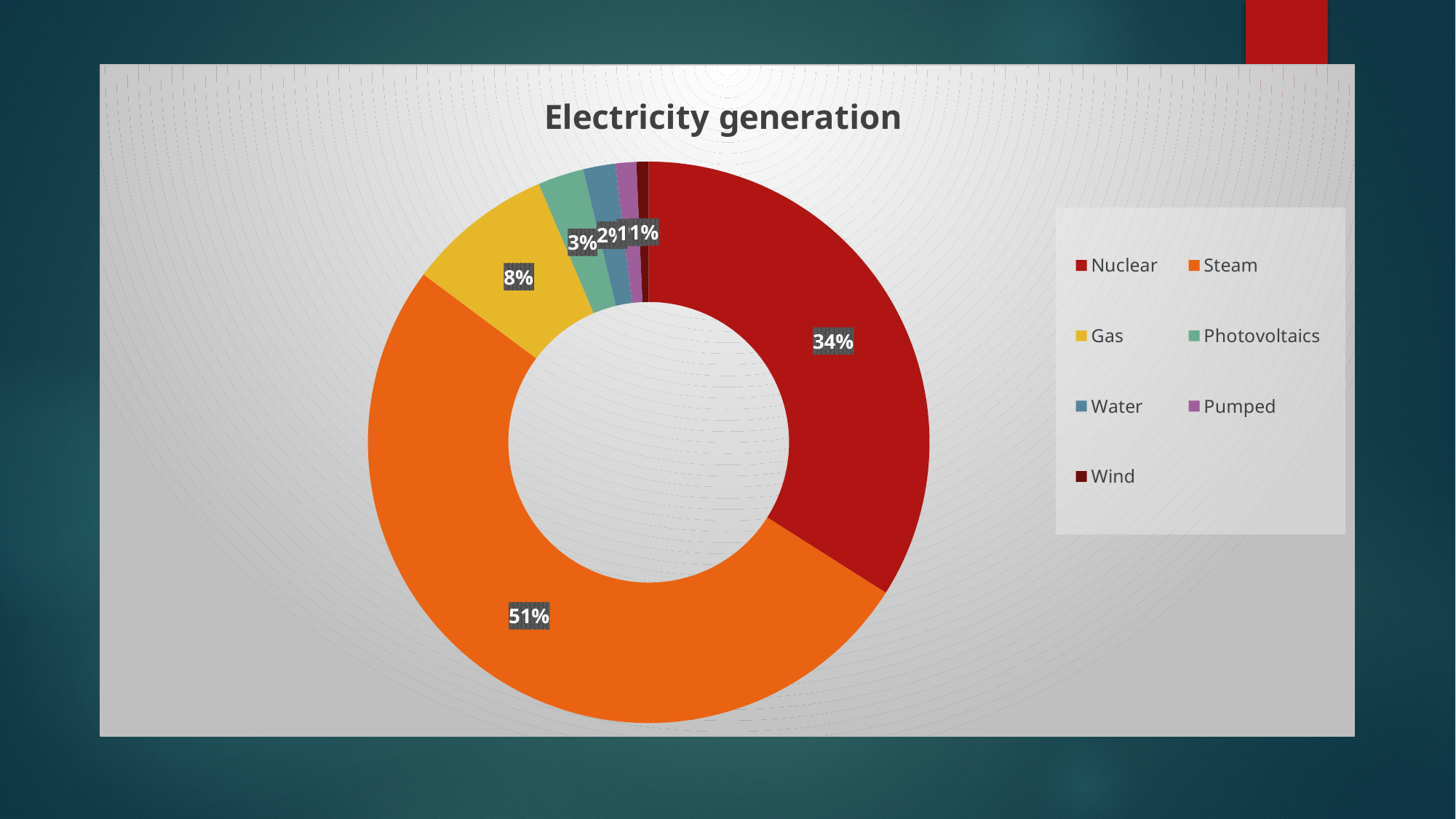
What percentage of electricity generation does Gas account for? 8% Which has a larger share, Nuclear or Gas? Nuclear What is the title of the chart? Electricity generation What colour represents Steam in the chart? orange How many categories does the legend list? 7 What percentage of electricity generation does Nuclear account for? 34% What kind of chart is shown on the slide? doughnut chart Which has a larger share, Gas or Photovoltaics? Gas How many percentage points larger is the Steam share than the Nuclear share? 17 percentage points What percentage of electricity generation does Photovoltaics account for? 3% Which category has the largest share of electricity generation? Steam What percentage of electricity generation does Steam account for? 51%